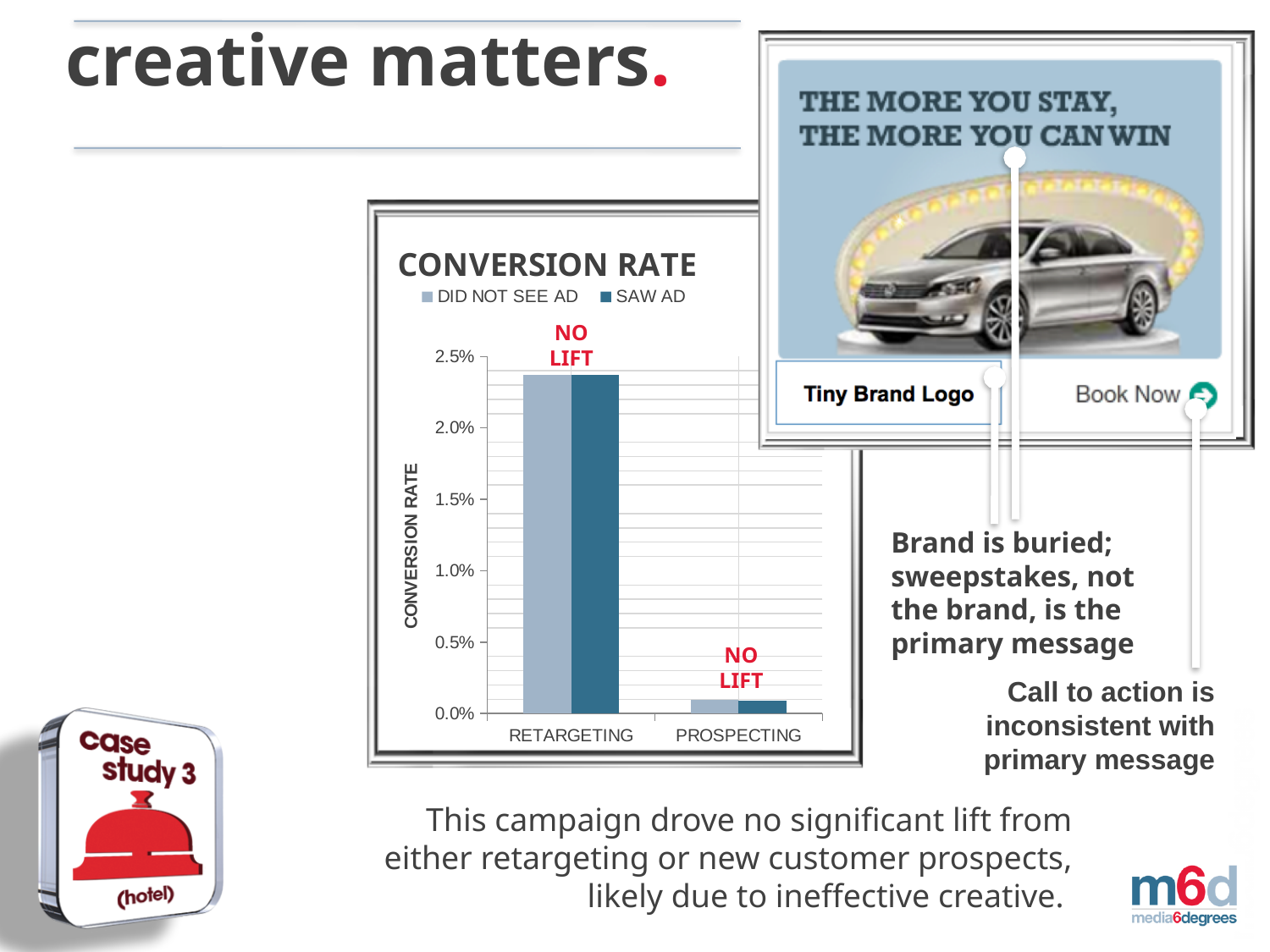
Do the conversion rates rise or fall moving from RETARGETING to PROSPECTING along the x axis? fall How many series does the chart's legend list? 2 Which category has the highest conversion rate in the chart? RETARGETING Is the DID NOT SEE AD conversion rate for RETARGETING greater or less than 1.5%? greater What kind of chart is shown on the slide? bar chart How many categories are shown on the x axis of the chart? 2 Is the SAW AD conversion rate for RETARGETING greater or less than 2.0%? greater Which has a larger SAW AD conversion rate, RETARGETING or PROSPECTING? RETARGETING Which category has the lowest conversion rate in the chart? PROSPECTING What are the two series named in the chart's legend? DID NOT SEE AD and SAW AD What is the title of the chart? CONVERSION RATE Is the DID NOT SEE AD conversion rate for PROSPECTING greater or less than 0.5%? less